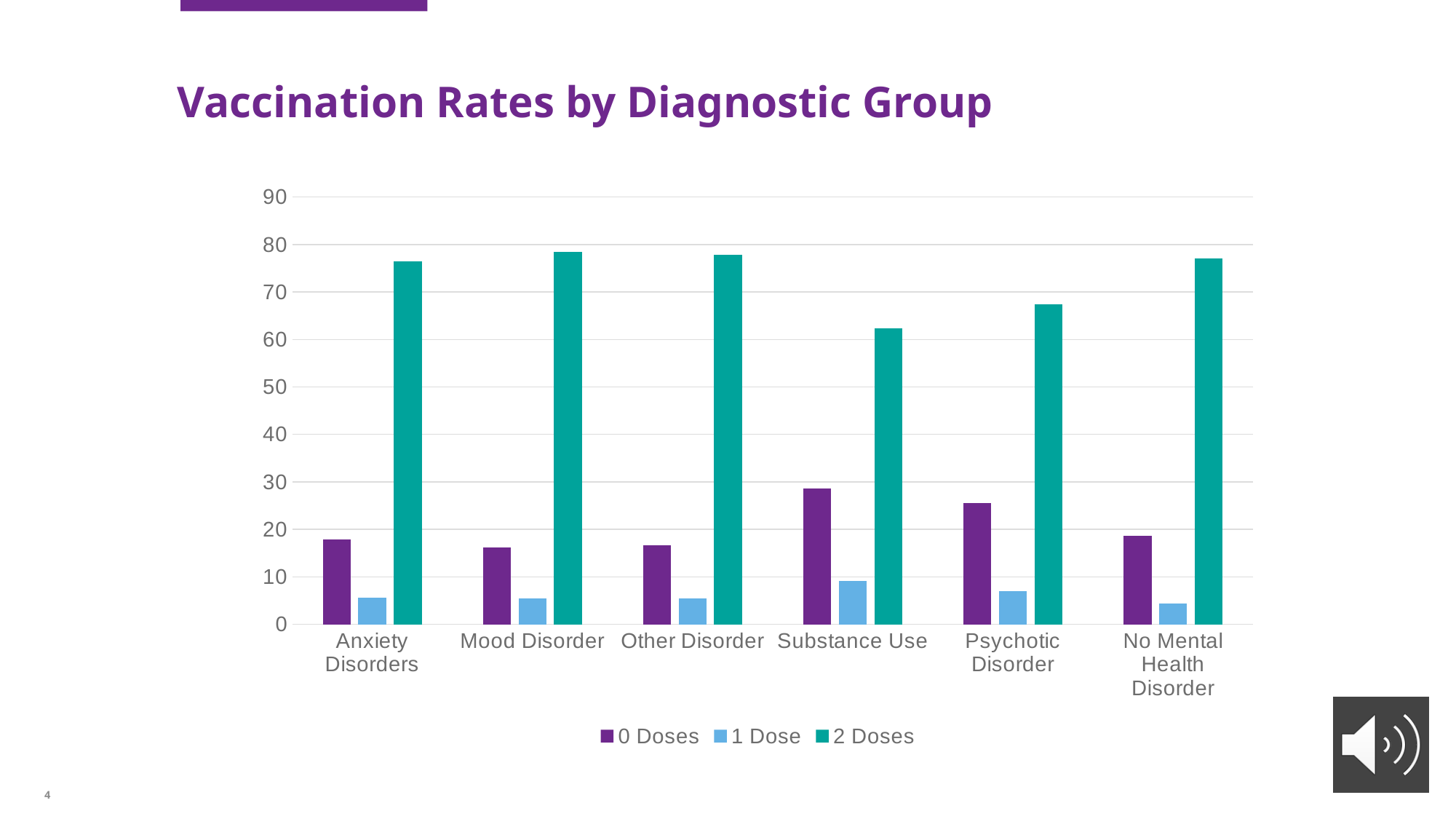
Which is larger, the 2 Doses value for Psychotic Disorder or the 2 Doses value for Substance Use? Psychotic Disorder Is the 2 Doses value for Substance Use greater or less than 70? less Is the 2 Doses value for Psychotic Disorder greater or less than 60? greater What is the title of the chart? Vaccination Rates by Diagnostic Group Is the 0 Doses value for Anxiety Disorders greater or less than 20? less How many diagnostic groups are shown on the x axis? 6 Which diagnostic group has the highest value for 0 Doses? Substance Use How many series does the legend list? 3 Which diagnostic group has the highest value for 1 Dose? Substance Use Which diagnostic group has the lowest value for 2 Doses? Substance Use What kind of chart is shown on the slide? bar chart Which is larger, the 0 Doses value for Substance Use or the 0 Doses value for Psychotic Disorder? Substance Use